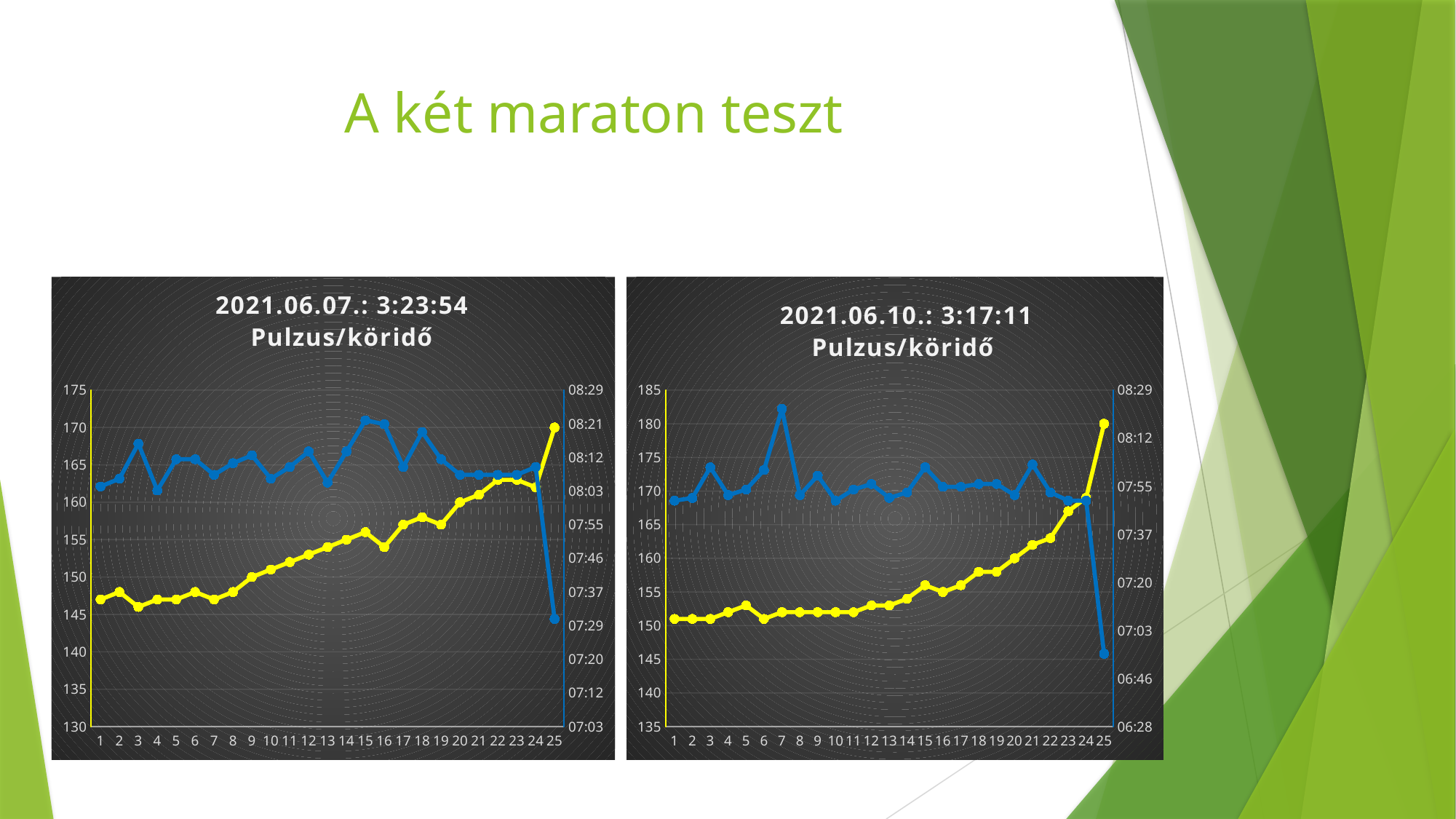
In the right chart titled "2021.06.10.: 3:17:11 Pulzus/köridő", at which x-axis point does the blue line reach its lowest value? 25 What is the title of the right chart? 2021.06.10.: 3:17:11 Pulzus/köridő In the right chart titled "2021.06.10.: 3:17:11 Pulzus/köridő", at which x-axis point does the blue line reach its highest value? 7 In the right chart titled "2021.06.10.: 3:17:11 Pulzus/köridő", which has the larger blue-line value: point 1 or point 7? point 7 How many points are plotted along the x axis of the right chart titled "2021.06.10.: 3:17:11 Pulzus/köridő"? 25 In the left chart titled "2021.06.07.: 3:23:54 Pulzus/köridő", at which x-axis point does the blue line reach its lowest value? 25 In the left chart titled "2021.06.07.: 3:23:54 Pulzus/köridő", does the yellow line generally rise or fall from point 1 to point 25? rise How many data series (lines) are plotted in the left chart titled "2021.06.07.: 3:23:54 Pulzus/köridő"? 2 In the left chart titled "2021.06.07.: 3:23:54 Pulzus/köridő", which has the larger blue-line value: point 3 or point 4? point 3 What kind of chart is the left chart titled "2021.06.07.: 3:23:54 Pulzus/köridő"? line chart